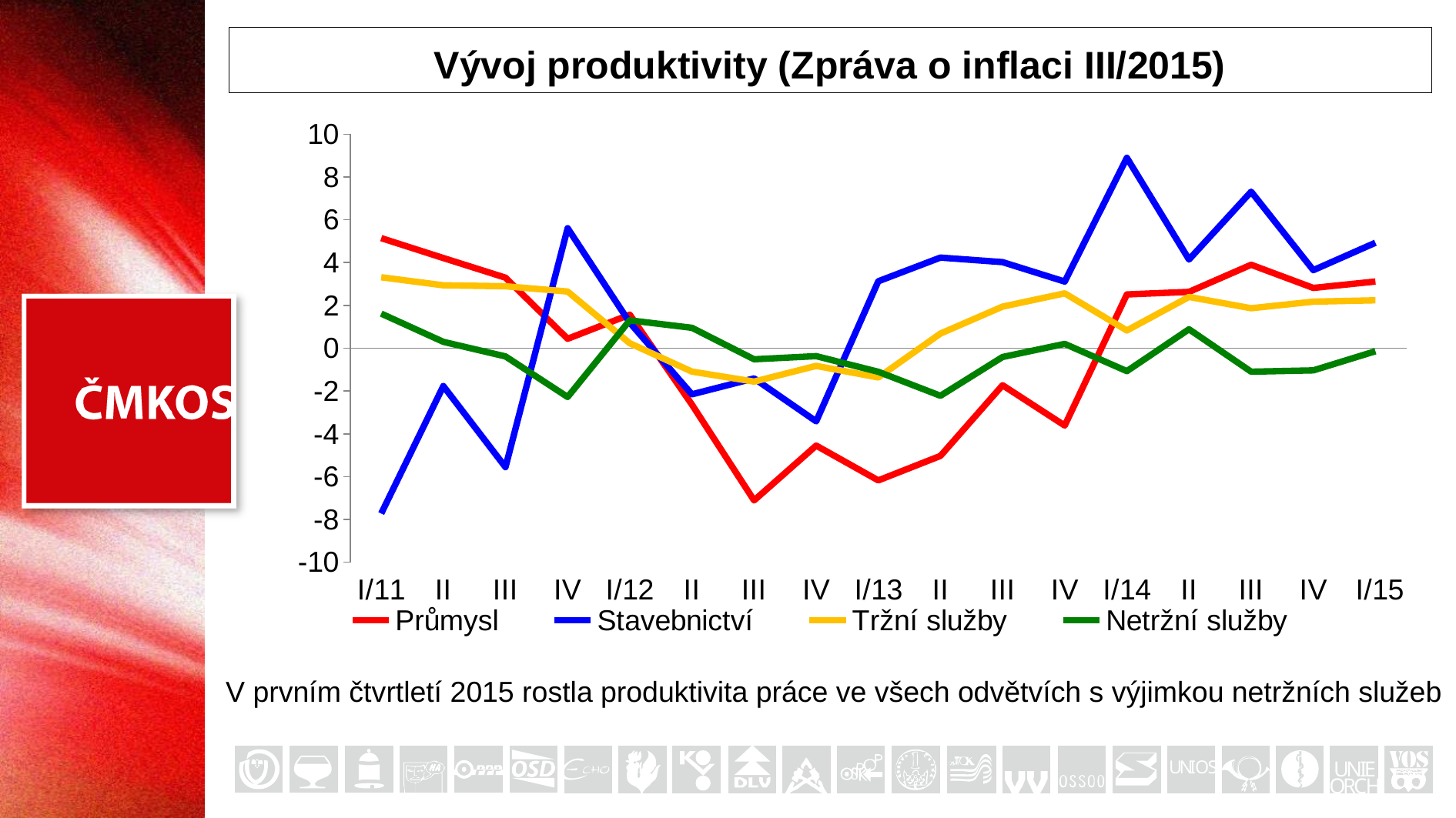
Is the value for Stavebnictví in I/14 greater or less than 8? greater Does the Průmysl series rise or fall between I/11 and III/12? fall Is the value for Stavebnictví in I/11 greater or less than -6? less In which quarter does the Průmysl series reach its lowest value? III/12 In I/14, which series has the higher value, Průmysl or Stavebnictví? Stavebnictví How many series does the legend list? 4 What kind of chart is shown on the slide? line chart Is the value for Průmysl in III/12 greater or less than -6? less In which quarter does the Stavebnictví series reach its highest value? I/14 How many quarters are labelled along the x axis? 17 In which quarter does the Stavebnictví series reach its lowest value? I/11